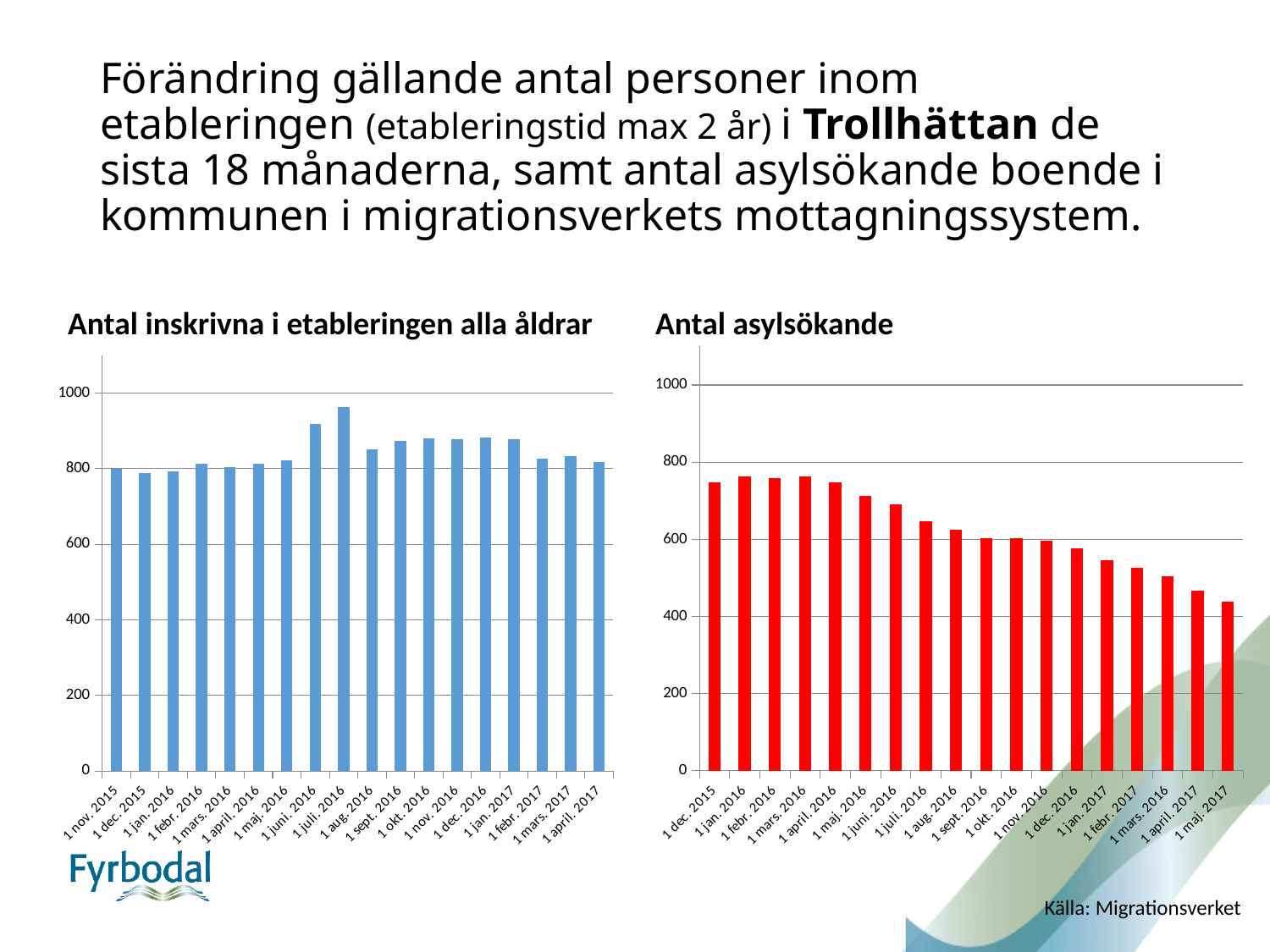
How many bars are plotted in the left chart 'Antal inskrivna i etableringen alla åldrar'? 18 What colour are the bars in the right chart 'Antal asylsökande'? red What kind of chart is the left chart, 'Antal inskrivna i etableringen alla åldrar'? bar chart In the right chart 'Antal asylsökande', is the value for 1 dec. 2015 greater or less than 600? greater In the left chart 'Antal inskrivna i etableringen alla åldrar', which is larger, the value for 1 juli. 2016 or the value for 1 dec. 2015? 1 juli. 2016 In the right chart 'Antal asylsökande', do the values generally rise or fall from 1 dec. 2015 to 1 maj. 2017? fall In the right chart 'Antal asylsökande', is the value for 1 maj. 2017 greater or less than 600? less In the right chart 'Antal asylsökande', which date has the lowest value? 1 maj. 2017 In the right chart 'Antal asylsökande', which is larger, the value for 1 juli. 2016 or the value for 1 april. 2017? 1 juli. 2016 In the left chart 'Antal inskrivna i etableringen alla åldrar', which date has the highest value? 1 juli. 2016 In the left chart 'Antal inskrivna i etableringen alla åldrar', is the value for 1 juli. 2016 greater or less than 800? greater